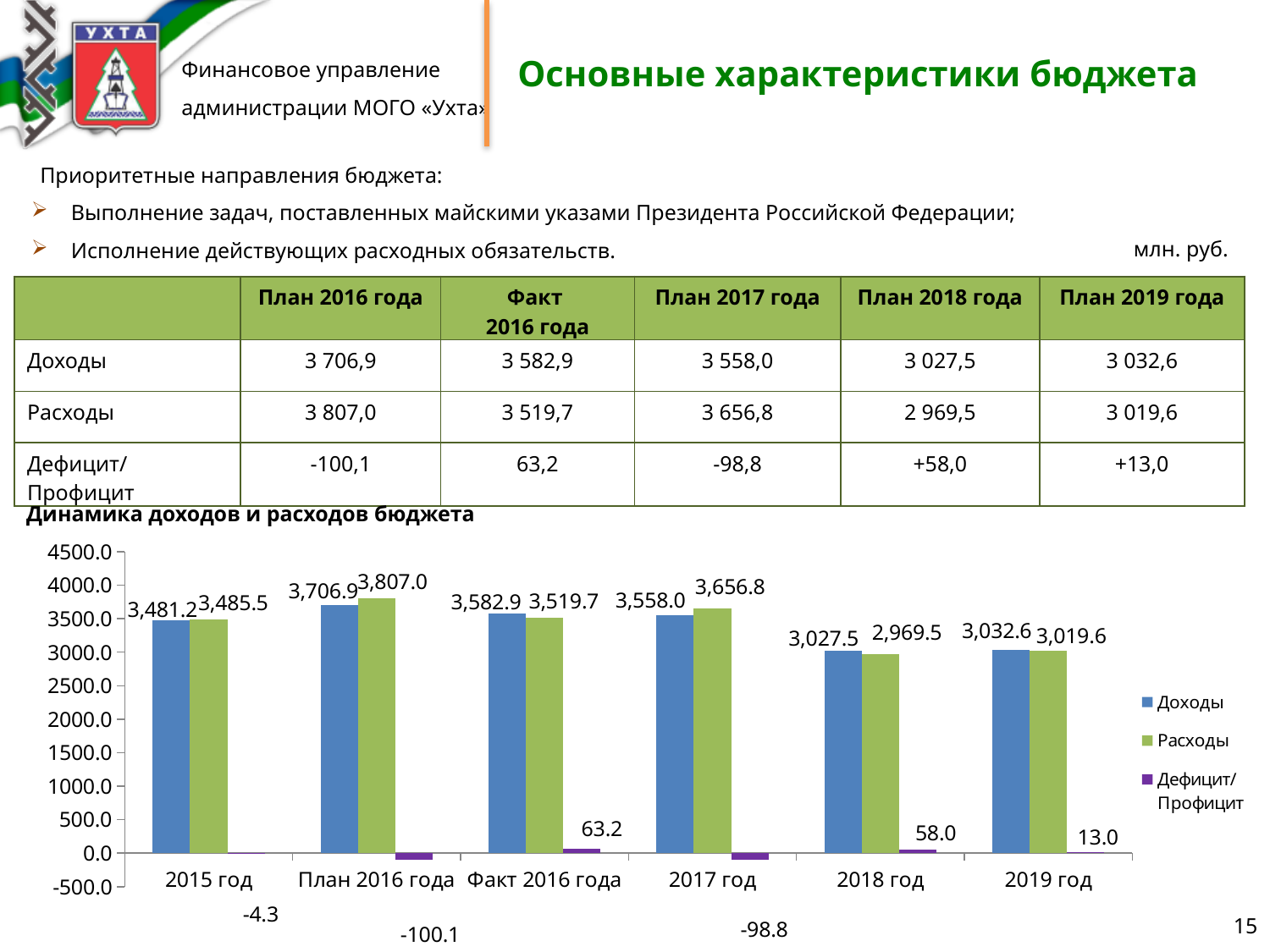
How many categories are shown along the x axis of the chart? 6 In the chart, which is larger for 2017 год: Доходы or Расходы? Расходы What is the value of Дефицит/Профицит for 2017 год in the chart? -98.8 Which category has the lowest value for Расходы in the chart? 2018 год In the chart, what is the difference between Расходы and Доходы for План 2016 года? 100.1 What is the value of Доходы for 2015 год in the chart? 3,481.2 Which category has the highest value for Расходы in the chart? План 2016 года What type of chart is shown under the heading 'Динамика доходов и расходов бюджета'? bar chart How many series does the legend of the chart list? 3 From Факт 2016 года to 2018 год, do the Доходы values rise or fall? fall Is the value of Доходы for 2018 год greater or less than 3000.0? greater What is the value of Расходы for 2019 год in the chart? 3,019.6